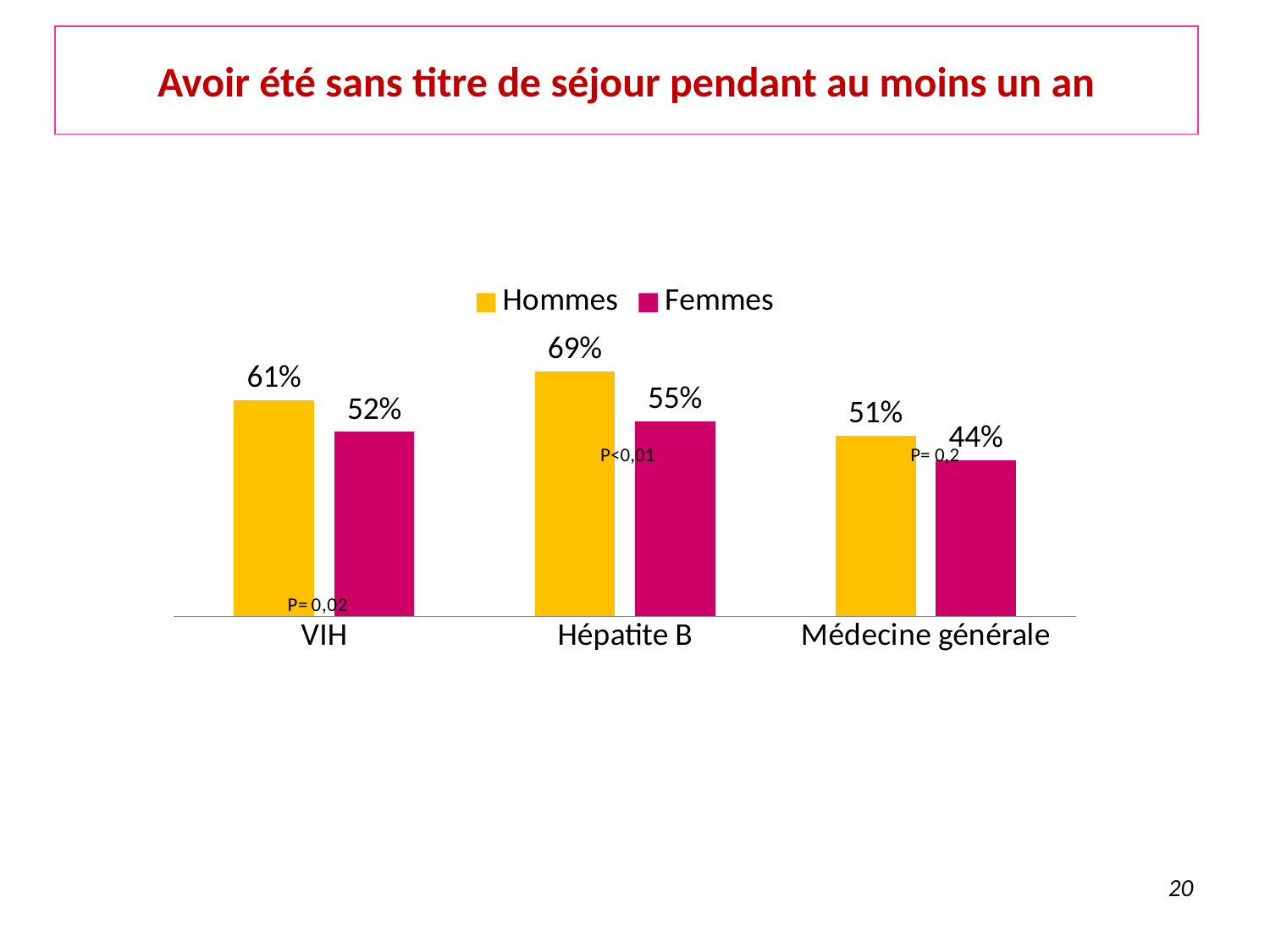
What is the difference between the Hommes values for Hépatite B and Médecine générale? 18% What colour are the Femmes bars? Magenta How many series does the legend list? 2 Which is larger in the VIH category, the Hommes value or the Femmes value? Hommes What kind of chart is shown on the slide? Bar chart What is the value for Femmes in the Hépatite B category? 55% How many categories are shown on the x axis? 3 What is the value for Femmes in the Médecine générale category? 44% What is the value for Hommes in the VIH category? 61% Which category has the lowest value for Femmes? Médecine générale Which category has the highest value for Hommes? Hépatite B What is the difference between the Hommes and Femmes values in the Hépatite B category? 14%